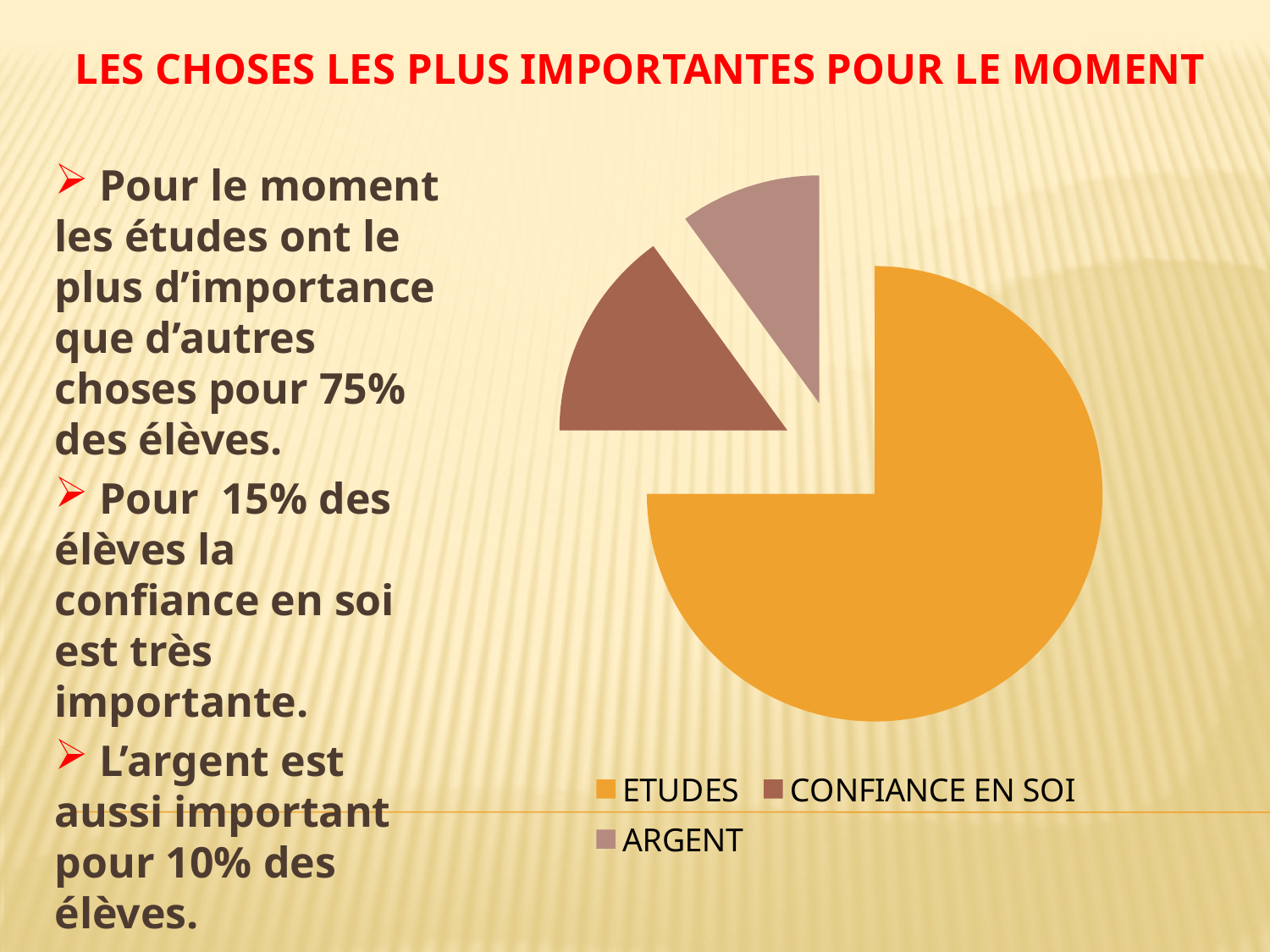
What kind of chart is shown on the slide? pie chart Which slice is larger, ETUDES or CONFIANCE EN SOI? ETUDES Which category has the largest slice in the pie chart? ETUDES What are the three categories listed in the legend of the pie chart? ETUDES, CONFIANCE EN SOI, ARGENT Which category has the smallest slice in the pie chart? ARGENT How many slices does the pie chart have? 3 Which slice is larger, CONFIANCE EN SOI or ARGENT? CONFIANCE EN SOI What colour is the ETUDES slice in the pie chart? orange Does the ETUDES slice take up more or less than half of the pie? more How many entries does the legend of the pie chart list? 3